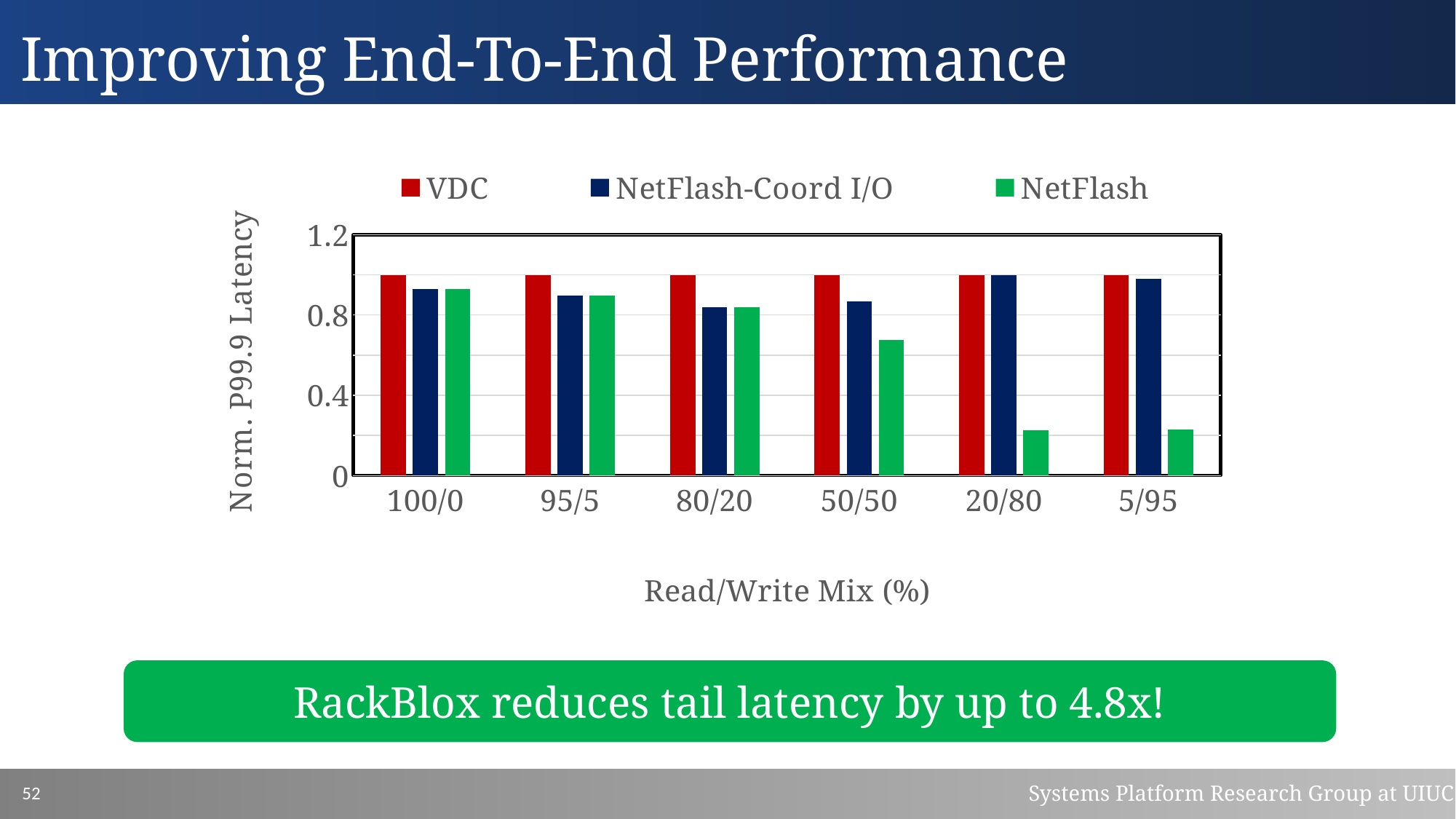
Do the NetFlash values rise or fall as the read/write mix moves from 100/0 to 5/95? fall Is the NetFlash value for the 50/50 mix greater or less than 0.8? less How many series does the legend list? 3 What is the label on the y axis of the chart? Norm. P99.9 Latency Is the NetFlash-Coord I/O value for the 80/20 mix greater or less than 0.8? greater Is the NetFlash value for the 20/80 mix greater or less than 0.4? less How many read/write mix categories are shown on the x axis? 6 What kind of chart is shown on the slide? bar chart Which is larger for the 50/50 mix, the NetFlash-Coord I/O value or the NetFlash value? NetFlash-Coord I/O Which is larger for the 5/95 mix, the VDC value or the NetFlash value? VDC Which series is shown in green in the legend? NetFlash